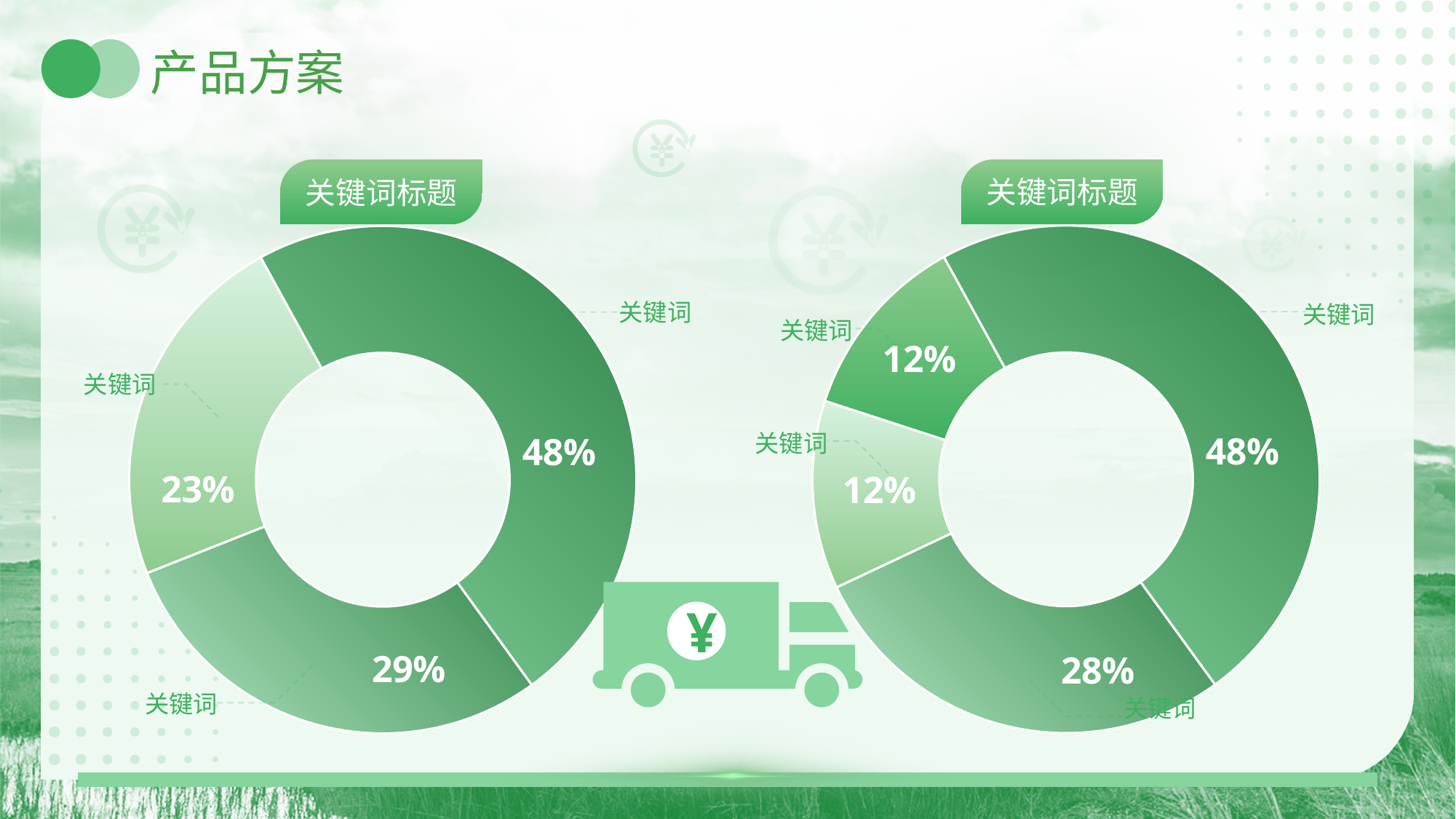
In the left donut chart, what is the difference between the largest slice (48%) and the smallest slice (23%)? 25 percentage points In the right donut chart, how many slices are labelled 12%? 2 What is the title of the slide? 产品方案 What kind of chart is shown on the left side of the slide? Donut (pie) chart How many slices does the left donut chart have? 3 In the right donut chart, what is the difference between the 48% slice and the 28% slice? 20 percentage points How many slices does the right donut chart have? 4 In the right donut chart, what is the value of the largest slice? 48% In the right donut chart, what is the value of the smallest slices? 12% In the left donut chart, what is the value of the smallest slice? 23% In the left donut chart, what is the value of the largest slice? 48% Which is larger: the second-largest slice of the left donut chart or the second-largest slice of the right donut chart? The left chart's (29% vs 28%)